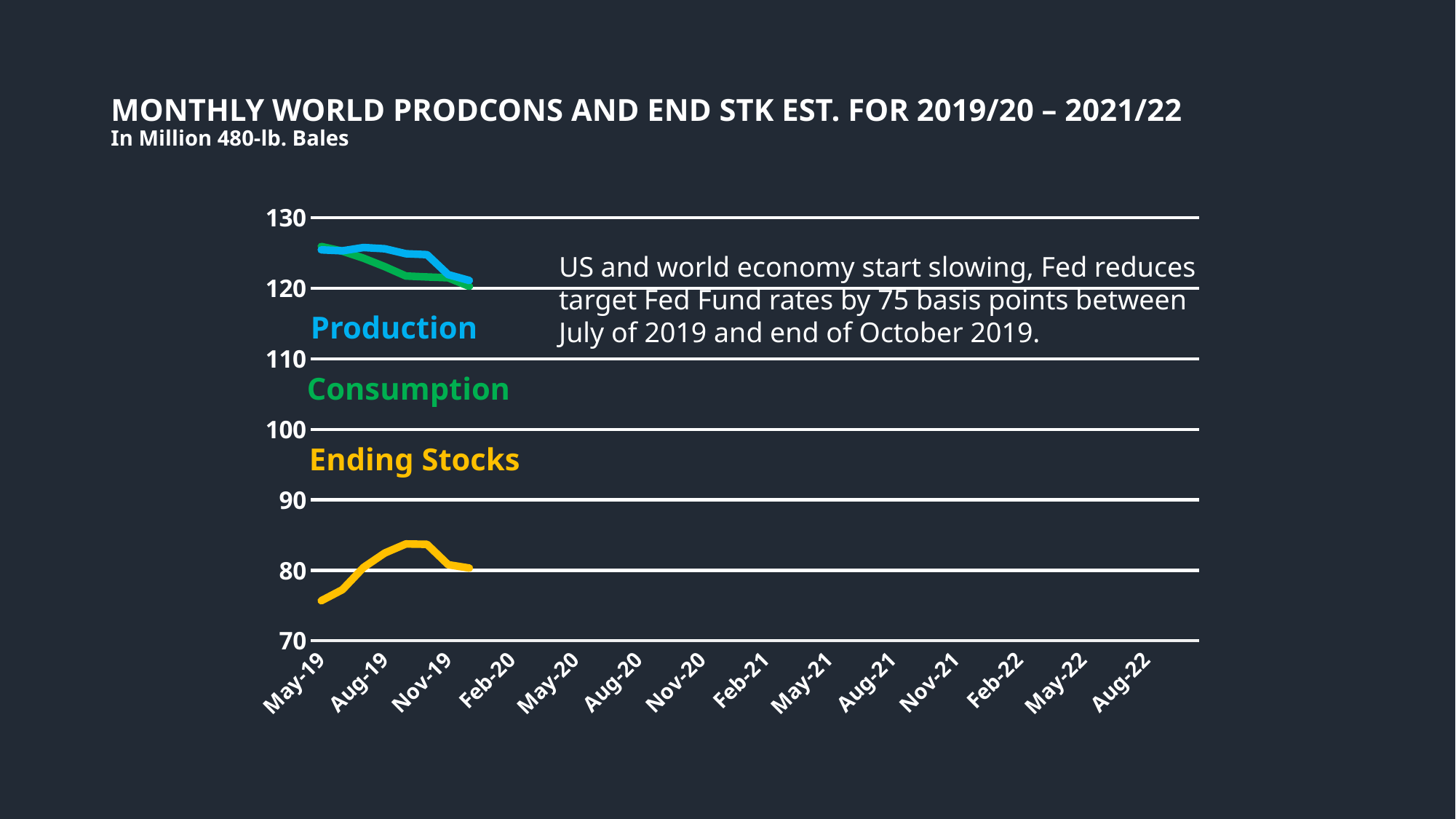
Does the Production line rise or fall from May-19 to its last plotted point? fall How many series are plotted on the chart? 3 How many month labels are shown along the x axis? 14 Is the value for Production at May-19 greater or less than 120? greater Is the value for Ending Stocks at May-19 greater or less than 80? less Is the value for Consumption at Nov-19 greater or less than 130? less In what units are the chart values expressed, according to the subtitle? In Million 480-lb. Bales Which series has the lowest values on the chart? Ending Stocks At Nov-19, which is larger: Production or Consumption? Production Does the Ending Stocks line rise or fall between May-19 and Nov-19? rise What kind of chart is shown on the slide? Line chart